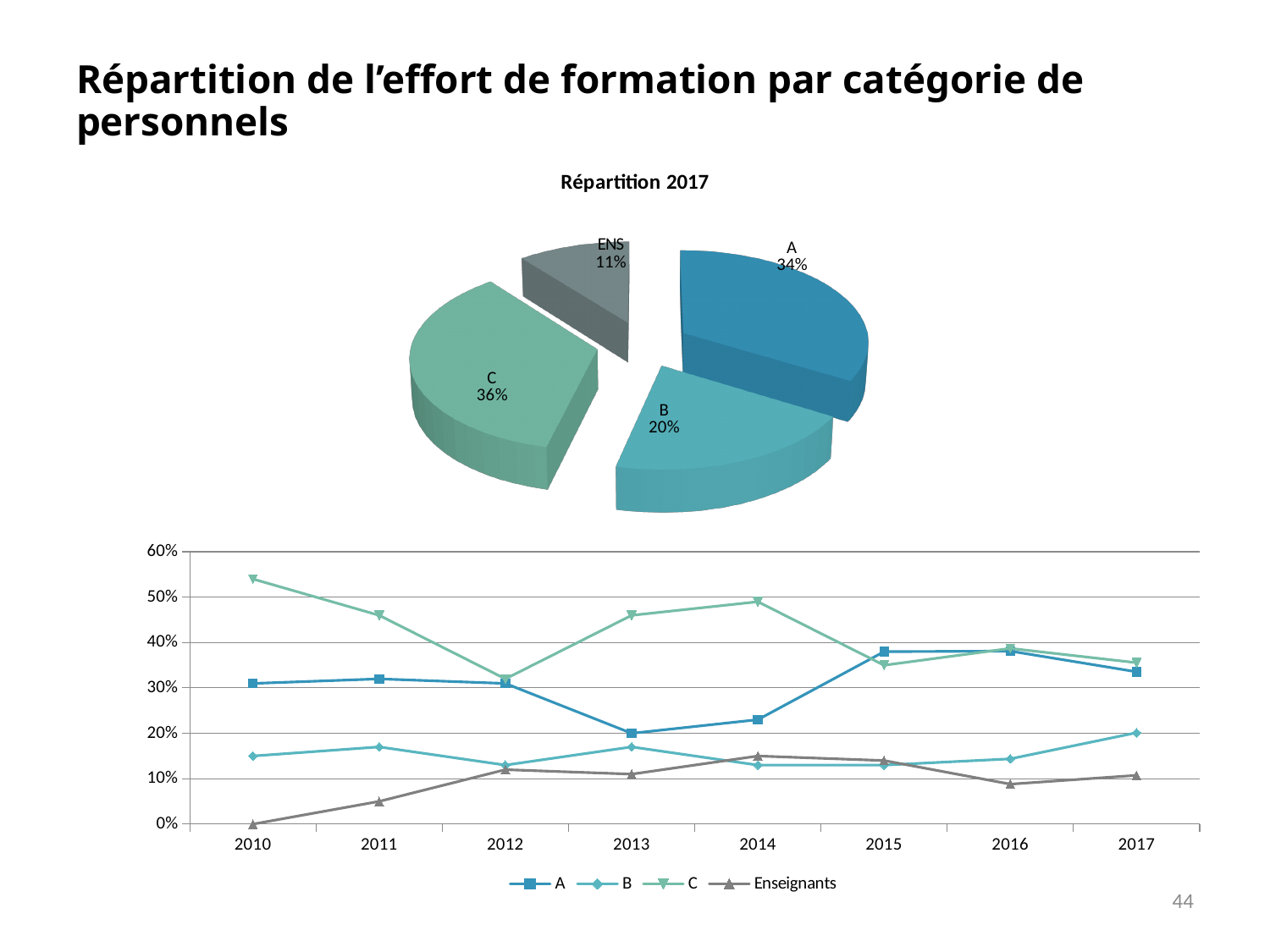
In the lower line chart, does the Enseignants series rise or fall from 2010 to 2014? rise In the lower line chart, is the value for C in 2010 greater or less than 50%? greater What kind of chart is the lower chart on the slide? line chart In the pie chart 'Répartition 2017', how many slices are there? 4 In the pie chart 'Répartition 2017', what share does category B have? 20% In the pie chart 'Répartition 2017', which category has the smallest share? ENS In the pie chart 'Répartition 2017', what share does category C have? 36% In the pie chart 'Répartition 2017', what is the difference in percentage points between A and B? 14 What kind of chart is the upper chart titled 'Répartition 2017'? pie chart In the pie chart 'Répartition 2017', which category has the largest share? C In the lower line chart, how many years are shown on the x axis? 8 In the lower line chart, how many series does the legend list? 4